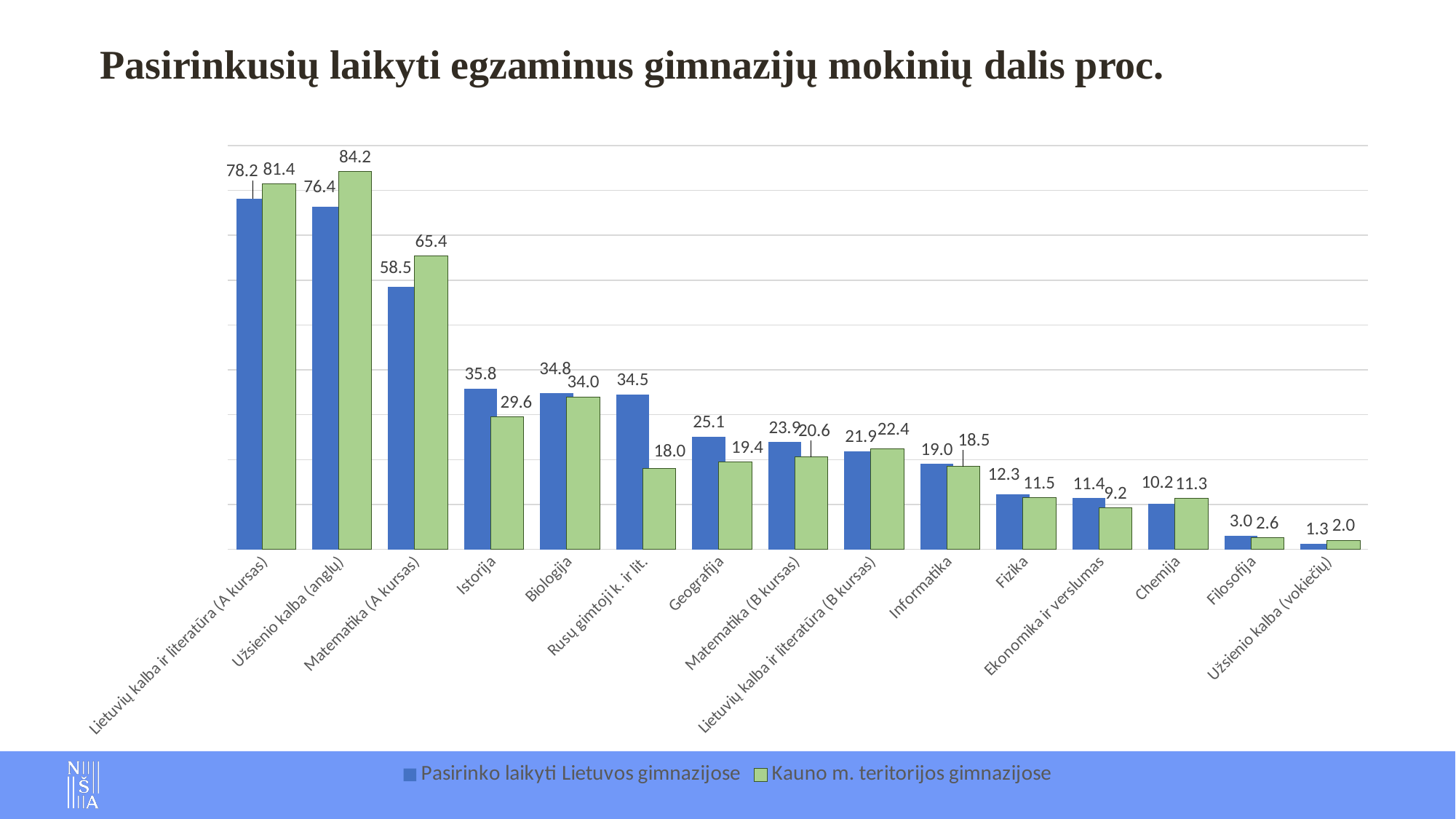
How many subject categories are shown on the x axis? 15 What is the value for Rusų gimtoji k. ir lit. in the 'Kauno m. teritorijos gimnazijose' series? 18.0 What is the title of the chart? Pasirinkusių laikyti egzaminus gimnazijų mokinių dalis proc. For Geografija, which series has the larger value? Pasirinko laikyti Lietuvos gimnazijose What is the value for Istorija in the 'Pasirinko laikyti Lietuvos gimnazijose' series? 35.8 What kind of chart is shown on the slide? bar chart What is the value for Matematika (A kursas) in the 'Kauno m. teritorijos gimnazijose' series? 65.4 Which category has the lowest value in the 'Pasirinko laikyti Lietuvos gimnazijose' series? Užsienio kalba (vokiečių) Which category has the highest value in the 'Kauno m. teritorijos gimnazijose' series? Užsienio kalba (anglų) What is the difference between the two series' values for Rusų gimtoji k. ir lit.? 16.5 How many series does the legend list? 2 What is the difference between the 'Kauno m. teritorijos gimnazijose' and 'Pasirinko laikyti Lietuvos gimnazijose' values for Užsienio kalba (anglų)? 7.8